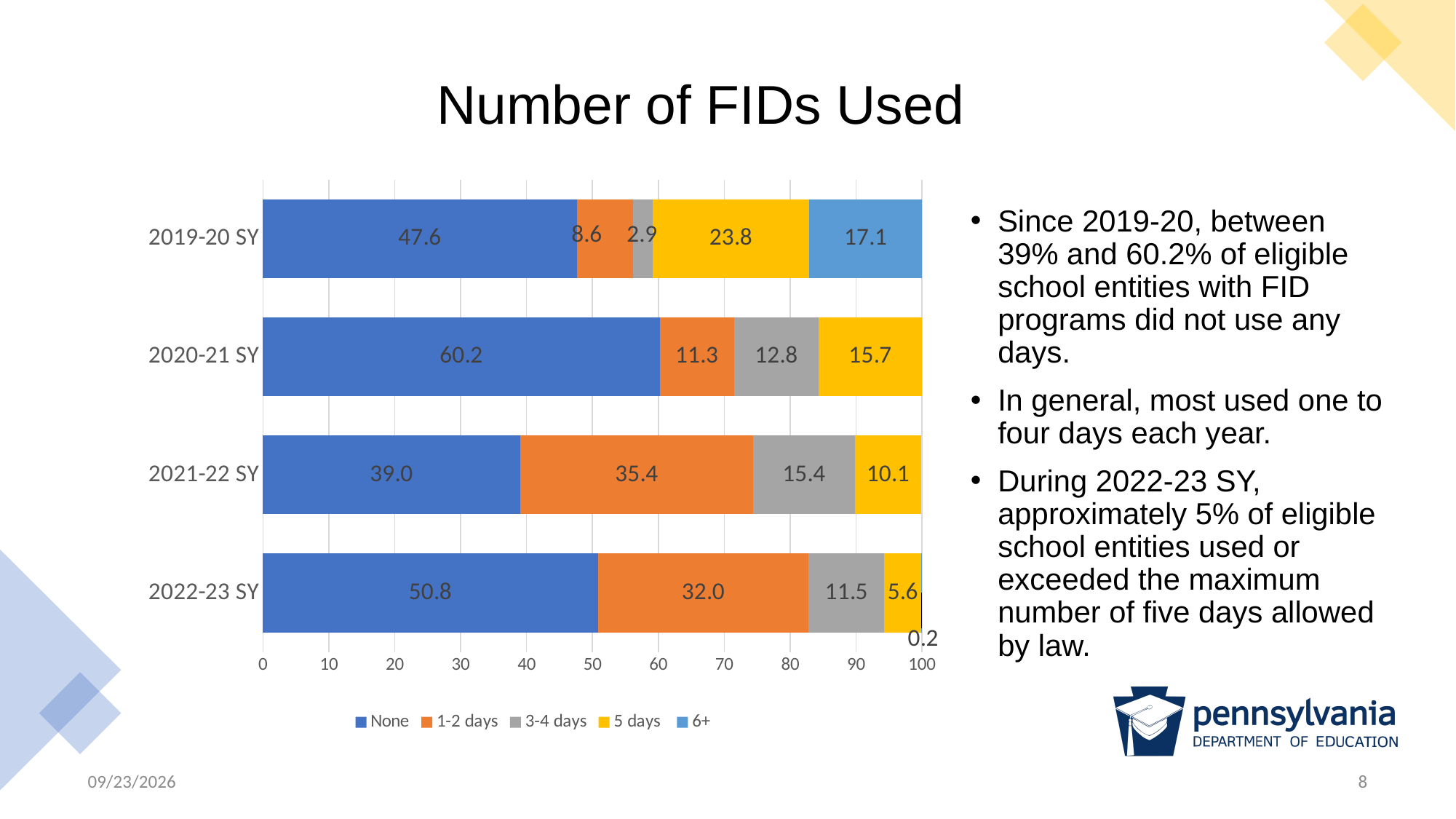
What type of chart is shown on the slide? Stacked bar chart Which school year has the highest value for 'None'? 2020-21 SY Which school year has the lowest value for 'None'? 2021-22 SY What is the value for '6+' in 2019-20 SY? 17.1 How many school years are shown on the chart? 4 What is the value for '5 days' in 2022-23 SY? 5.6 Which is larger: the '3-4 days' value for 2020-21 SY or for 2019-20 SY? 2020-21 SY How many series does the legend list? 5 What is the difference between the 'None' values for 2020-21 SY and 2021-22 SY? 21.2 What is the value for 'None' in 2020-21 SY? 60.2 What is the title of the chart? Number of FIDs Used What is the value for '1-2 days' in 2021-22 SY? 35.4